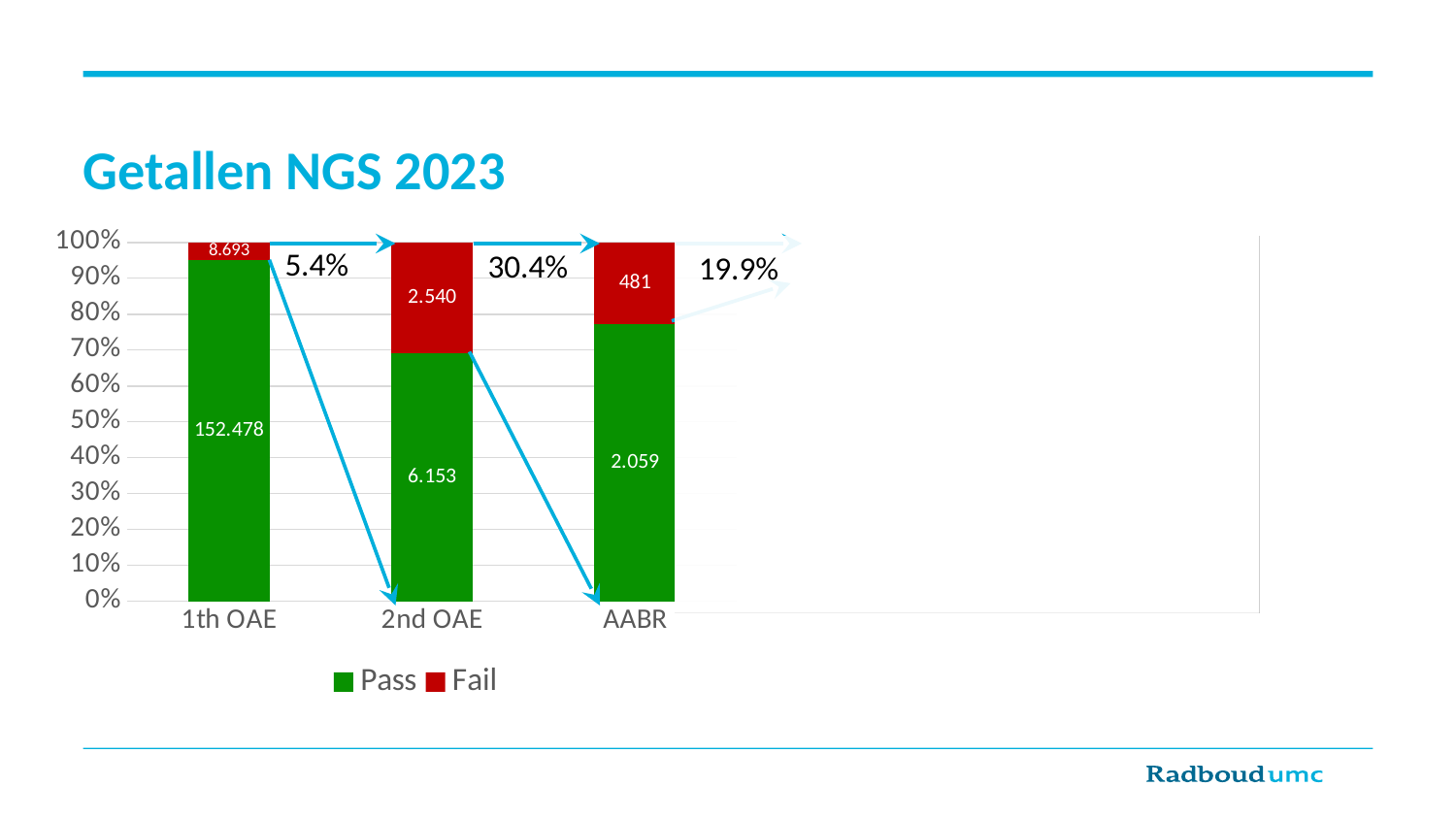
What is the Pass value for 1th OAE? 152.478 Is the Pass share of the 2nd OAE bar greater or less than 80%? less Which category has the highest Pass value? 1th OAE What is the Pass value for AABR? 2.059 What is the total of the Pass and Fail values for AABR? 2.540 What is the Fail value for 2nd OAE? 2.540 What is the difference between the Fail value for 2nd OAE and the Fail value for AABR? 2.059 Which category has the lowest Fail value? AABR What is the Fail value for AABR? 481 What kind of chart is shown on the slide? Stacked bar chart Which is larger, the Pass value for 2nd OAE or the Pass value for AABR? Pass value for 2nd OAE How many categories are shown on the x axis? 3